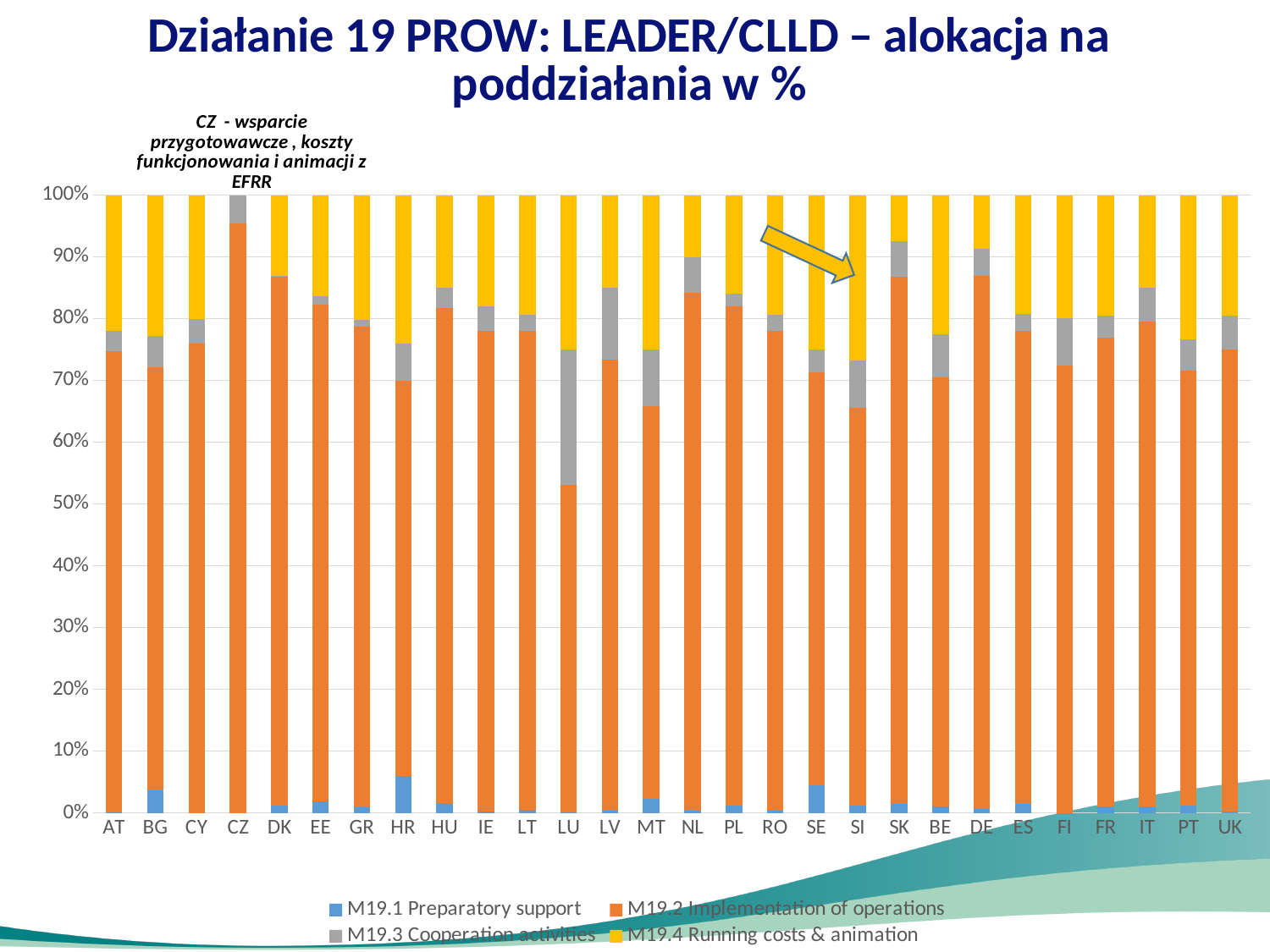
What kind of chart is shown on the slide? stacked bar chart Is the top of the M19.2 Implementation of operations segment for CZ greater or less than 90%? greater Which country has the largest M19.1 Preparatory support segment? HR Which is larger, the M19.2 Implementation of operations segment for CZ or for LU? CZ How many countries are shown on the x axis? 28 Which country has the smallest M19.4 Running costs & animation segment? CZ What is the total height of each stacked bar? 100% How many series does the legend list? 4 Is the M19.1 Preparatory support value for HR greater or less than 10%? less Is the top of the M19.2 Implementation of operations segment for MT greater or less than 70%? less Which country has the largest M19.3 Cooperation activities segment? LU